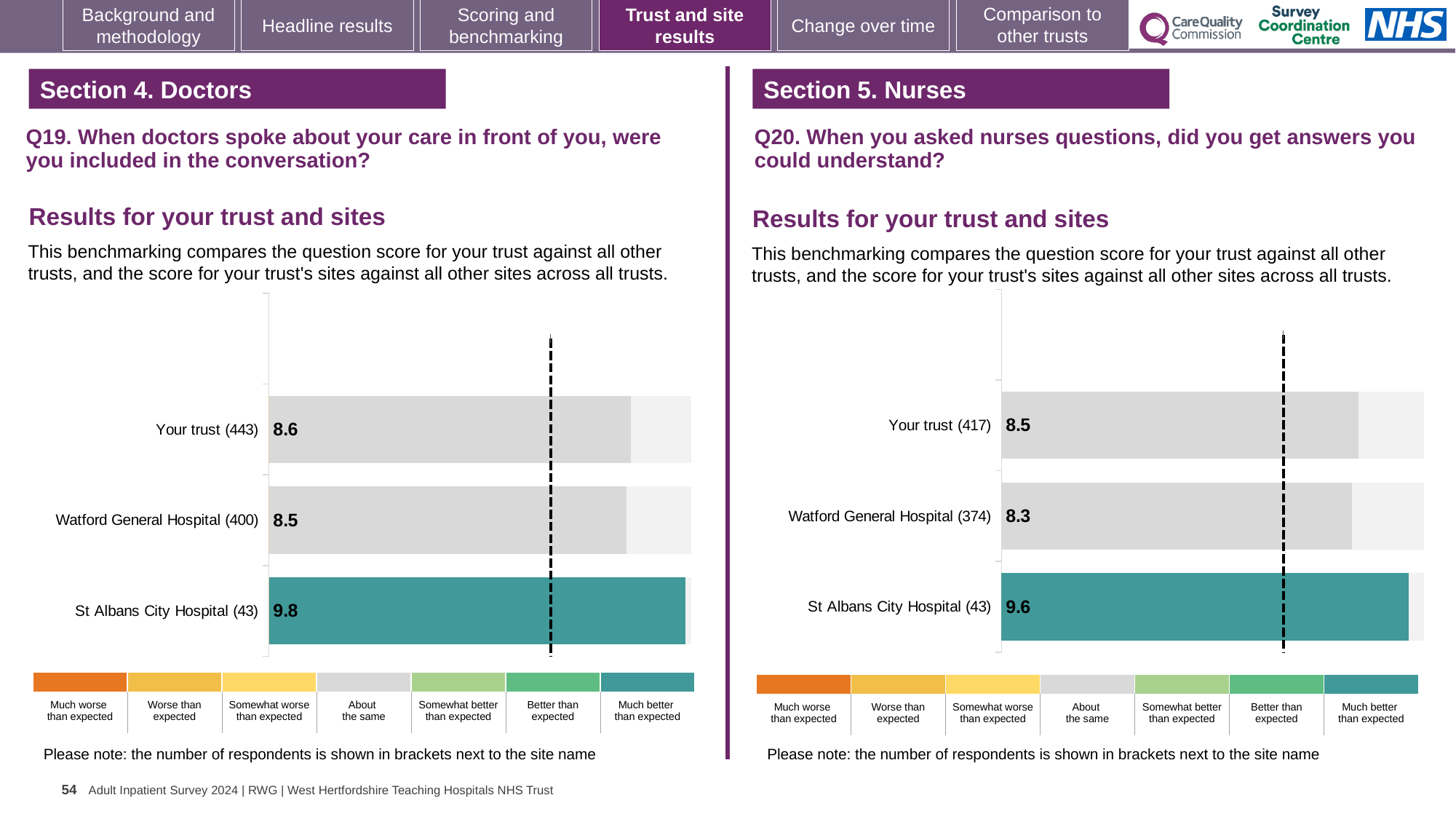
In the Q19 chart on the left, what is the difference between the St Albans City Hospital score and the Watford General Hospital score? 1.3 In the Q19 chart on the left, what is the score for St Albans City Hospital? 9.8 In the Q19 chart on the left, how many respondents are shown in brackets for Watford General Hospital? 400 In the Q20 chart on the right, which site or trust has the lowest score? Watford General Hospital In the Q19 chart on the left, what is the score for Your trust? 8.6 In the Q20 chart on the right, what is the score for St Albans City Hospital? 9.6 How many bars are plotted in the Q19 chart on the left? 3 In the Q20 chart on the right, which has the larger score, Your trust or St Albans City Hospital? St Albans City Hospital In the Q20 chart on the right, what is the score for Watford General Hospital? 8.3 What type of chart is used in the Q20 chart on the right? Bar chart In the Q20 chart on the right, what is the difference between the Your trust score and the Watford General Hospital score? 0.2 In the Q19 chart on the left, which site or trust has the highest score? St Albans City Hospital